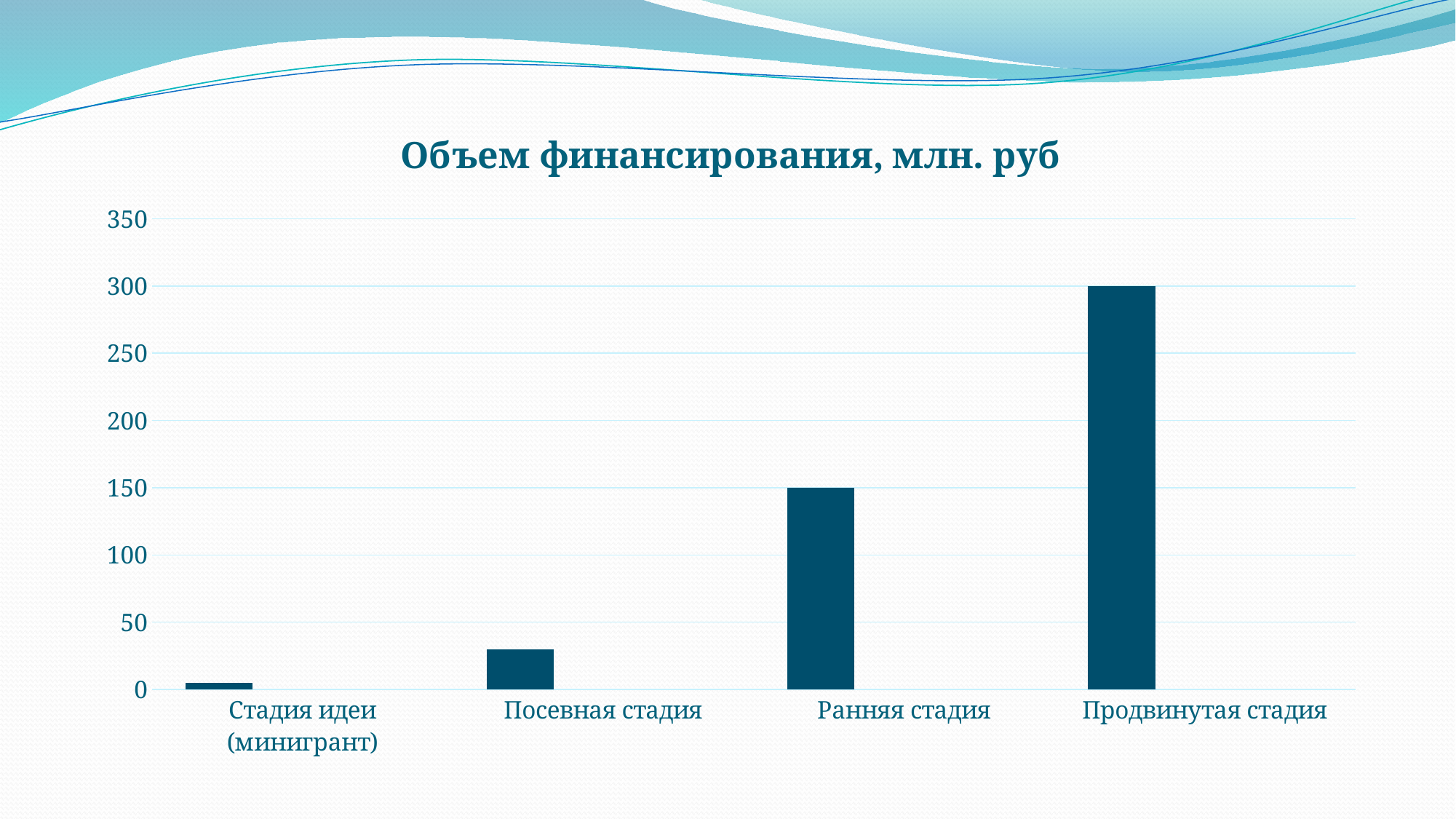
Which category has the lowest value? Стадия идеи (минигрант) Which is larger, the value for Посевная стадия or the value for Ранняя стадия? Ранняя стадия Do the values rise or fall from left to right along the x axis? rise What is the value for Ранняя стадия? 150 How many categories are shown on the x axis of the chart? 4 Is the value for Посевная стадия greater or less than 50? less What is the title of the chart? Объем финансирования, млн. руб What type of chart is shown on the slide? bar chart What is the value for Продвинутая стадия? 300 Is the value for Стадия идеи (минигрант) greater or less than 50? less Which category has the highest value? Продвинутая стадия What is the difference between the values for Продвинутая стадия and Ранняя стадия? 150